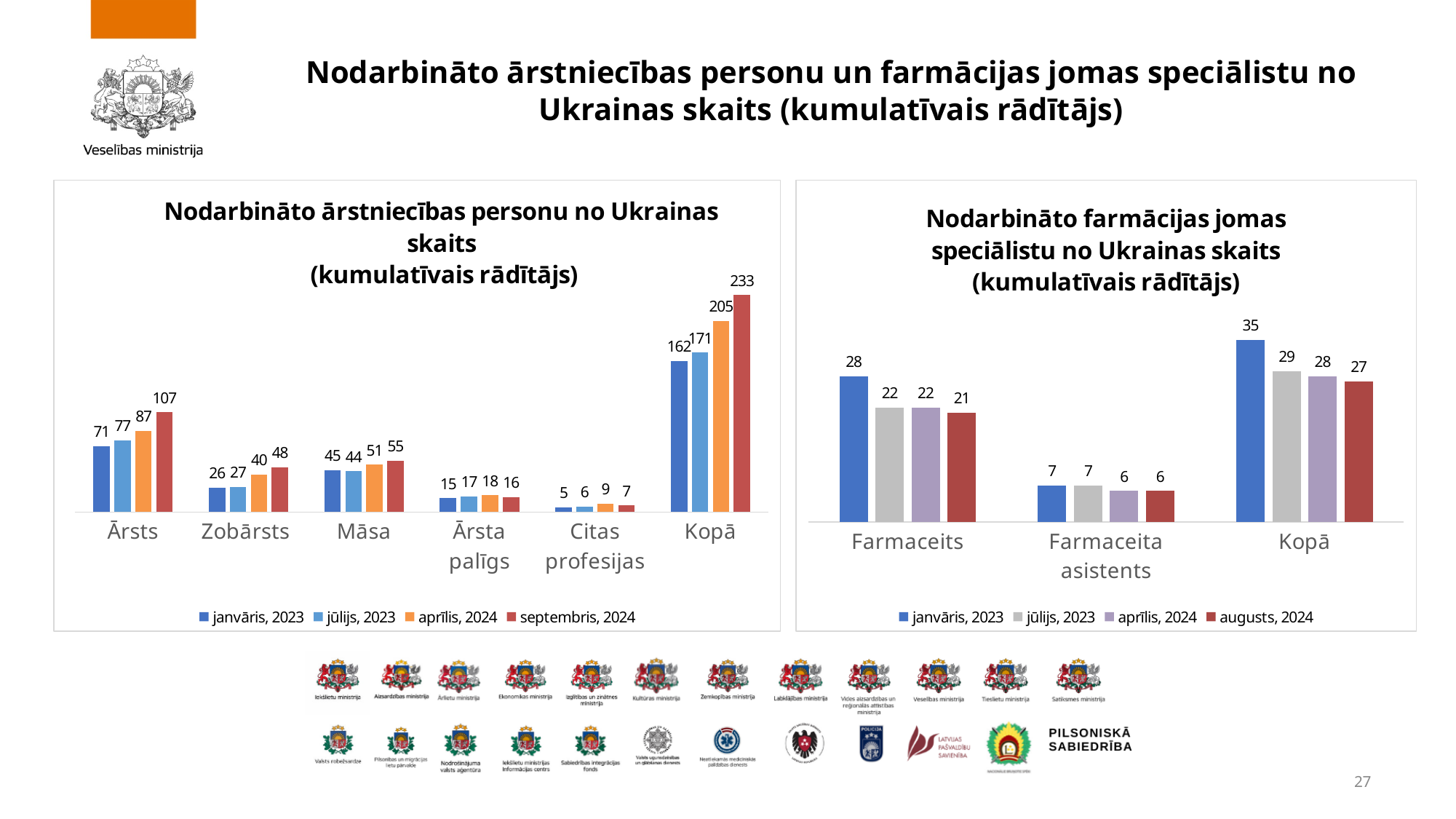
In the left chart (Nodarbināto ārstniecības personu no Ukrainas skaits), which is larger for Māsa: the value for janvāris, 2023 or the value for aprīlis, 2024? aprīlis, 2024 In the right chart (Nodarbināto farmācijas jomas speciālistu no Ukrainas skaits), which category has the highest value in janvāris, 2023? Kopā In the left chart (Nodarbināto ārstniecības personu no Ukrainas skaits), what is the value for Ārsts in septembris, 2024? 107 In the left chart (Nodarbināto ārstniecības personu no Ukrainas skaits), what is the difference between the Kopā values for septembris, 2024 and janvāris, 2023? 71 What kind of chart is the right chart (Nodarbināto farmācijas jomas speciālistu no Ukrainas skaits)? Bar chart In the right chart (Nodarbināto farmācijas jomas speciālistu no Ukrainas skaits), do the Kopā values rise or fall from janvāris, 2023 to augusts, 2024? Fall In the right chart (Nodarbināto farmācijas jomas speciālistu no Ukrainas skaits), what is the difference between the Farmaceits values for janvāris, 2023 and augusts, 2024? 7 How many series does the legend of the right chart (Nodarbināto farmācijas jomas speciālistu no Ukrainas skaits) list? 4 In the left chart (Nodarbināto ārstniecības personu no Ukrainas skaits), what is the value for Kopā in janvāris, 2023? 162 In the right chart (Nodarbināto farmācijas jomas speciālistu no Ukrainas skaits), what is the value for Farmaceits in jūlijs, 2023? 22 In the left chart (Nodarbināto ārstniecības personu no Ukrainas skaits), which category has the lowest value in septembris, 2024? Citas profesijas How many categories are shown on the x axis of the left chart (Nodarbināto ārstniecības personu no Ukrainas skaits)? 6